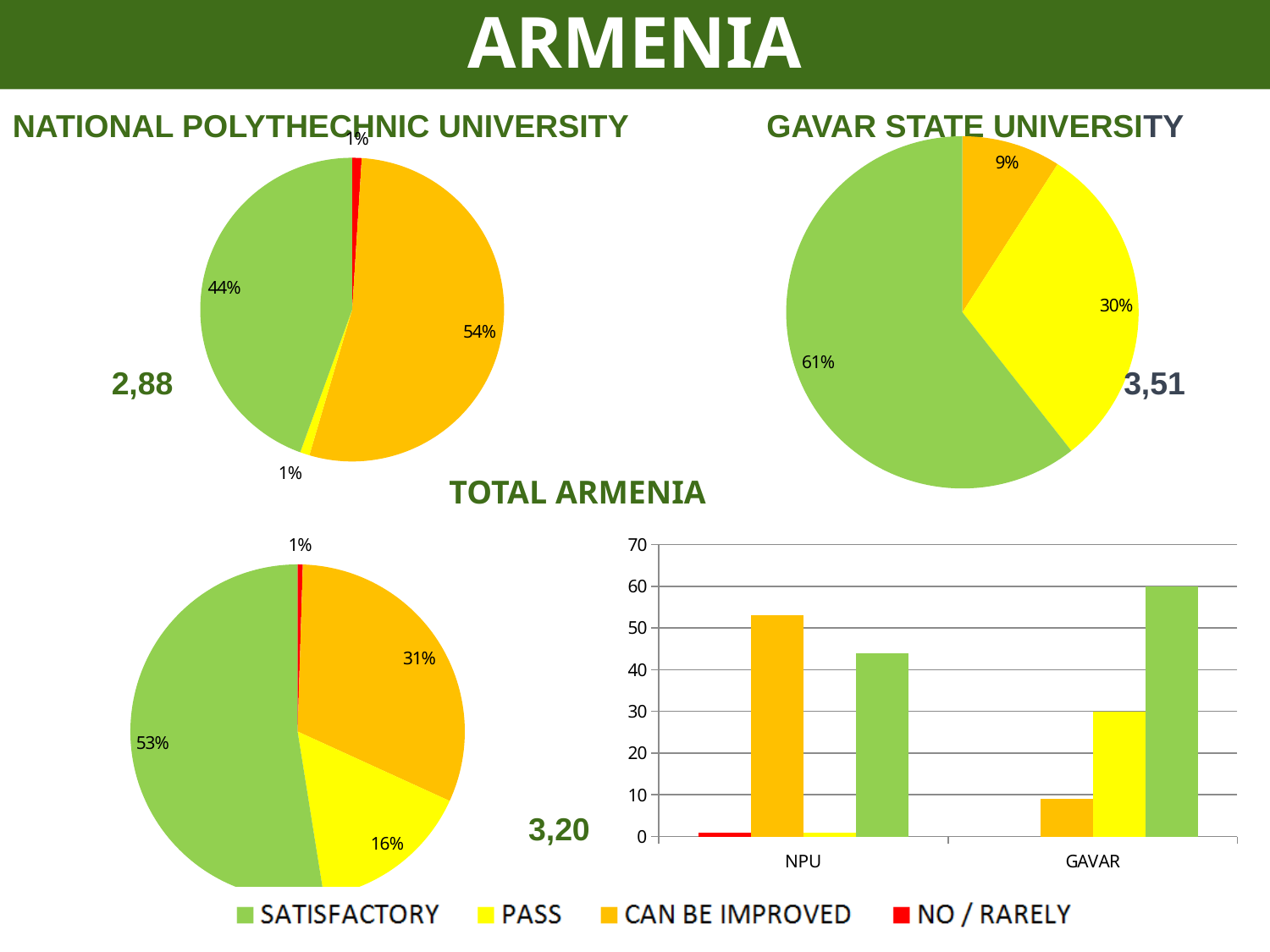
How many series does the legend at the bottom of the slide list? 4 In the Gavar State University pie chart, what share is labelled for the Pass slice? 30% In the bar chart at the bottom right, is the Can Be Improved bar for NPU greater or less than 50? greater In the National Polytechnic University pie chart, what share is labelled for the Can Be Improved slice? 54% In the Total Armenia pie chart, what share is labelled for the Pass slice? 16% In the Gavar State University pie chart, which category has the largest slice? Satisfactory In the Total Armenia pie chart, which is larger, the Can Be Improved slice or the Pass slice? Can Be Improved In the National Polytechnic University pie chart, what share is labelled for the Satisfactory slice? 44% In the Total Armenia pie chart, what is the difference between the Satisfactory share and the Can Be Improved share? 22% How many categories are shown on the x axis of the bar chart at the bottom right? 2 In the bar chart at the bottom right, is the Satisfactory bar for GAVAR greater or less than 50? greater In the Gavar State University pie chart, which category has the smallest slice? Can Be Improved